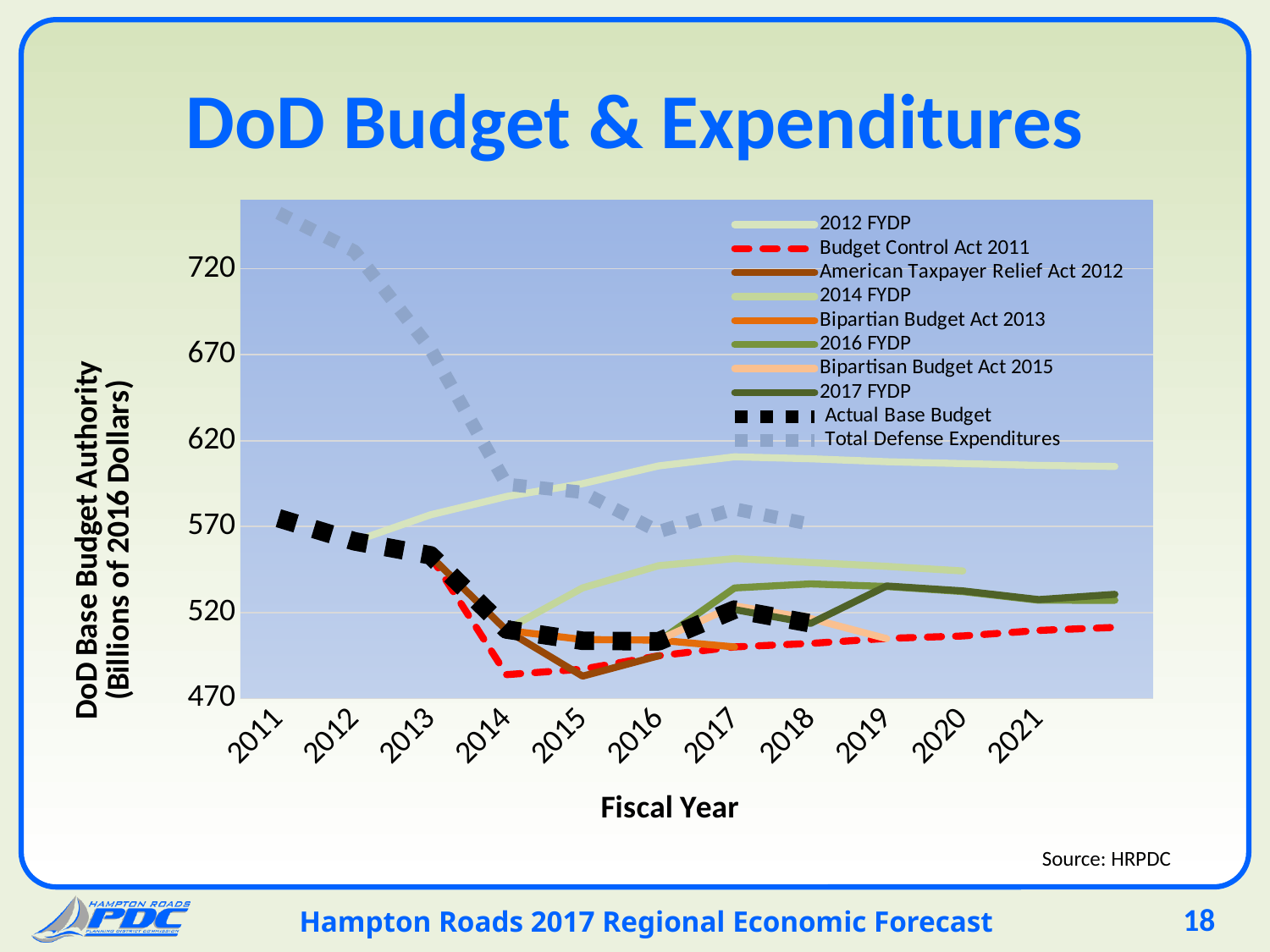
Is the value for Total Defense Expenditures in 2011 greater or less than 720? greater Does the Total Defense Expenditures series rise or fall from 2011 to 2016? fall What kind of chart is shown on the slide? line chart What is the title of the chart? DoD Budget & Expenditures How many fiscal years are shown on the x axis? 11 Is the value for Budget Control Act 2011 in 2014 greater or less than 520? less Which series reaches the highest value on the chart? Total Defense Expenditures How many series does the legend list? 10 In 2017, which is larger: 2012 FYDP or Budget Control Act 2011? 2012 FYDP Is the value for 2012 FYDP in 2017 greater or less than 620? less What is the label of the y axis? DoD Base Budget Authority (Billions of 2016 Dollars)